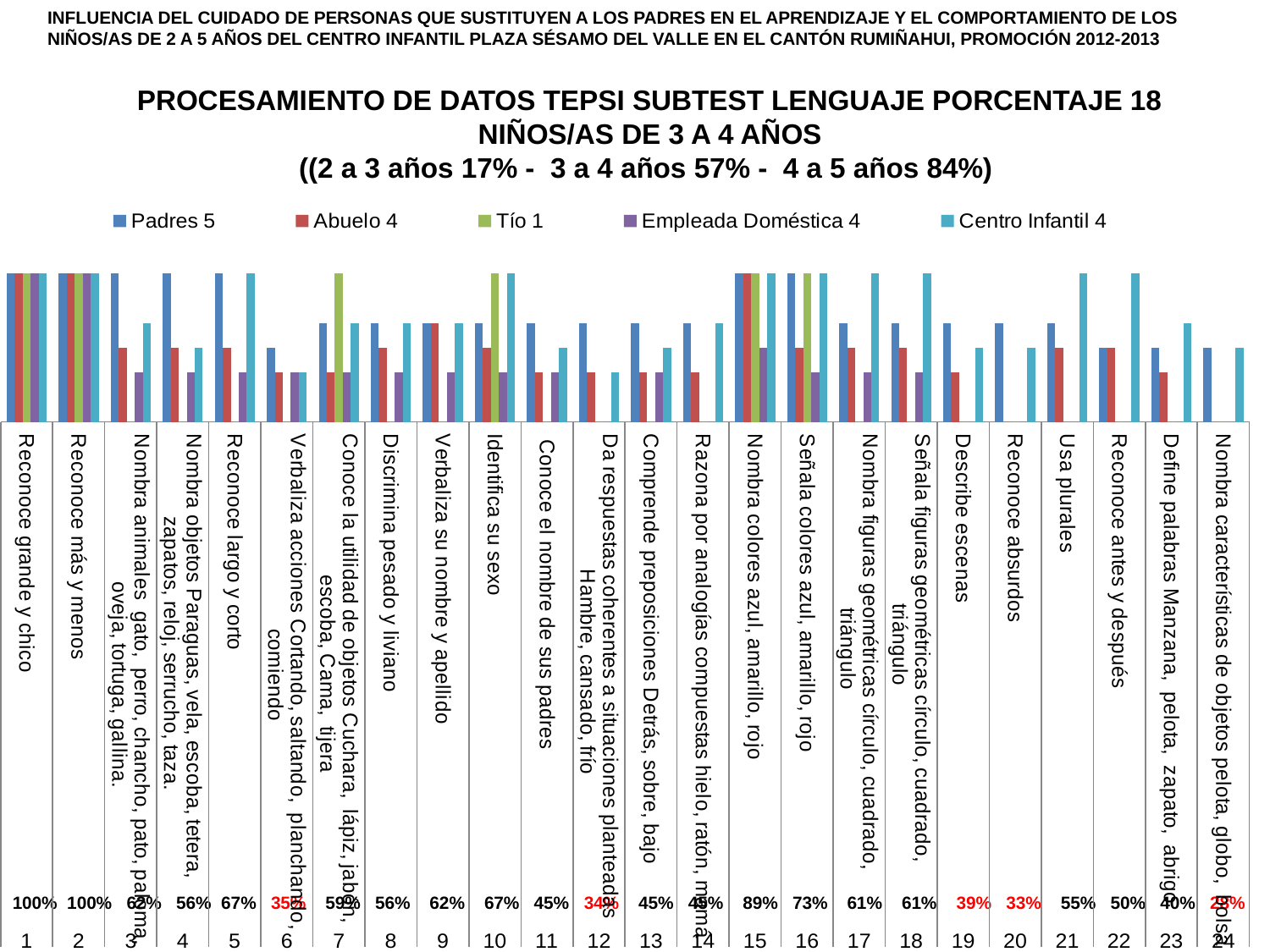
What kind of chart is shown on the slide? bar chart What is the difference between the overall percentages printed for item 15 (89%) and item 16 (73%)? 16% Among the overall percentages printed below the items, which item number has the lowest value? 24 What overall percentage is printed below item 24, "Nombra características de objetos pelota, globo, bolsa"? 28% What overall percentage is printed below item 16, "Señala colores azul, amarillo, rojo"? 73% Which has the larger overall percentage printed below it: item 19 "Describe escenas" or item 21 "Usa plurales"? Usa plurales What overall percentage is printed below item 1, "Reconoce grande y chico"? 100% What overall percentage is printed below item 15, "Nombra colores azul, amarillo, rojo"? 89% How many series does the legend list? 5 How many numbered categories are shown along the x axis? 24 Which series is listed first in the legend? Padres 5 What overall percentage is printed below item 20, "Reconoce absurdos"? 33%